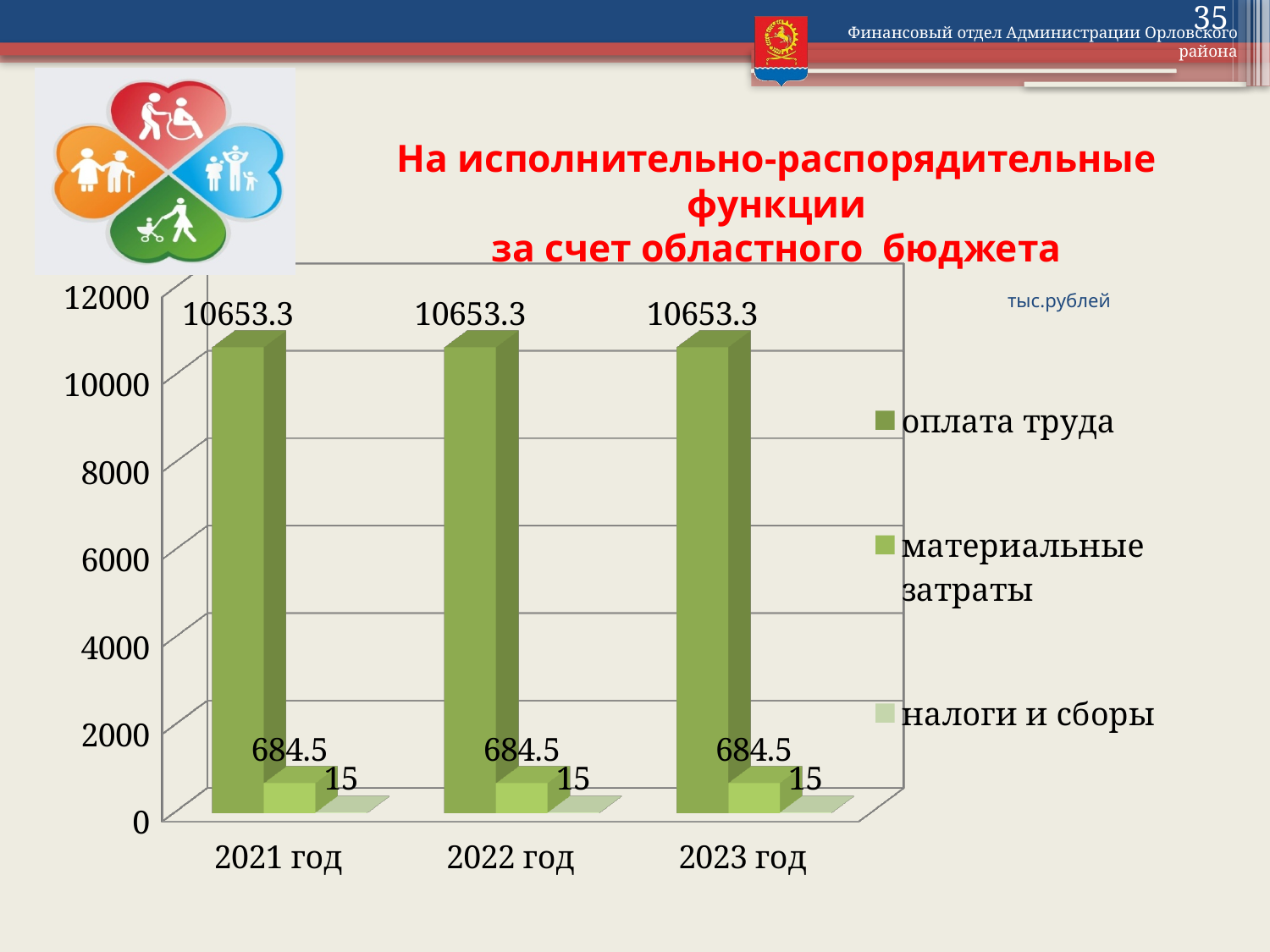
What is the value for налоги и сборы in 2023 год? 15 How many years are shown on the x axis? 3 What is the value for материальные затраты in 2022 год? 684.5 What kind of chart is shown on the slide? bar chart How many series does the legend list? 3 Which is larger in 2021 год: материальные затраты or налоги и сборы? материальные затраты What is the value for оплата труда in 2021 год? 10653.3 Which series has the highest value in 2023 год? оплата труда Is the value for оплата труда in 2022 год greater or less than 10000? greater Does the value for оплата труда rise, fall or stay the same from 2021 год to 2023 год? stays the same Which series has the lowest value in 2021 год? налоги и сборы What is the difference between оплата труда and материальные затраты in 2022 год? 9968.8